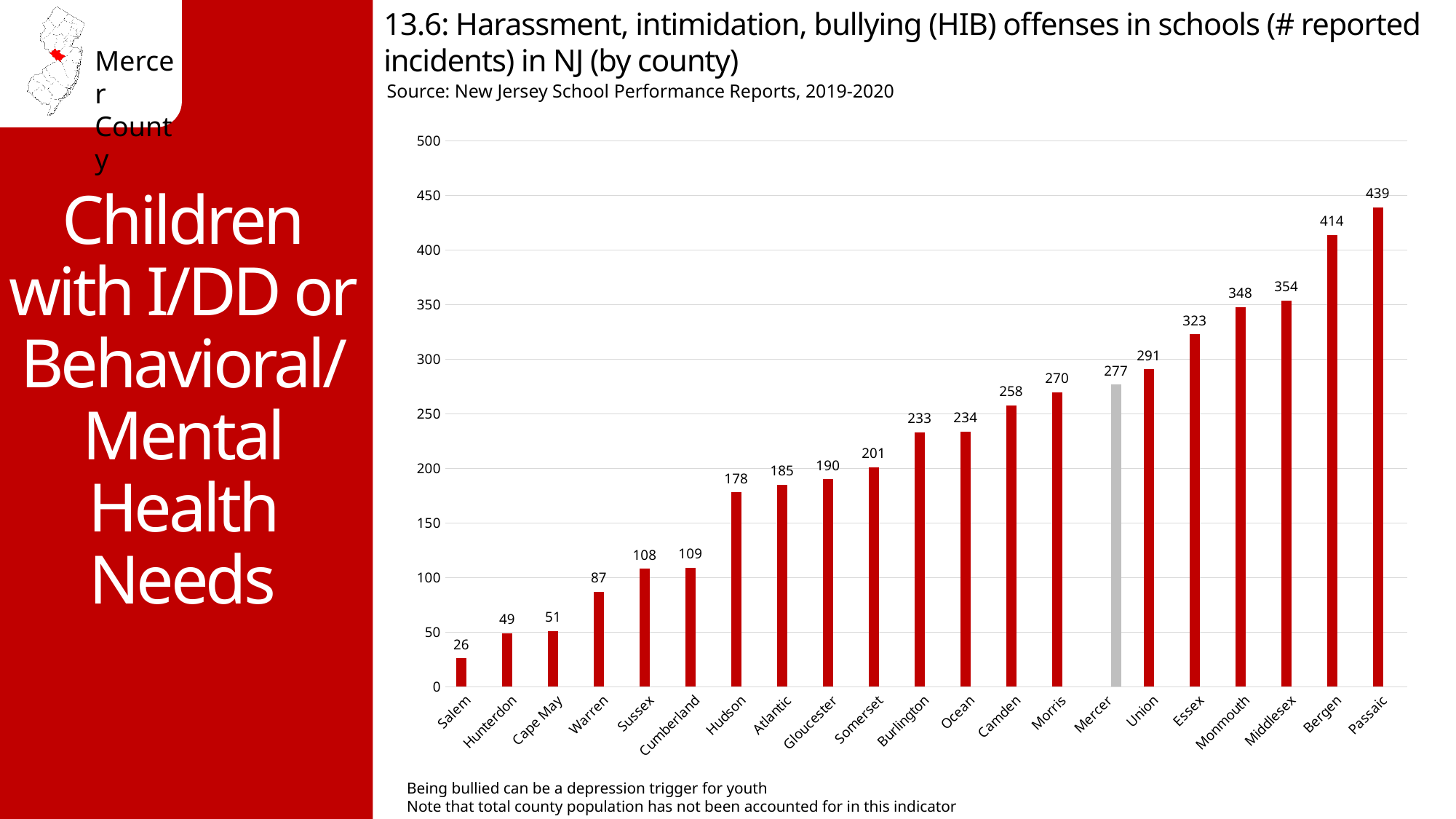
What kind of chart is shown on the slide? Bar chart What is the value shown for Hudson? 178 What is the difference between the values for Mercer and Salem? 251 Is the value for Monmouth greater or less than 300? greater Which has more reported HIB incidents, Essex or Union? Essex Do the values rise or fall moving from left to right along the x axis? Rise How many reported HIB incidents does the chart show for Mercer County? 277 Which county has the lowest number of reported HIB incidents? Salem Which county has the highest number of reported HIB incidents? Passaic Which county's bar is coloured grey instead of red? Mercer What is the difference between the values for Passaic and Bergen? 25 How many counties are shown on the x axis? 21